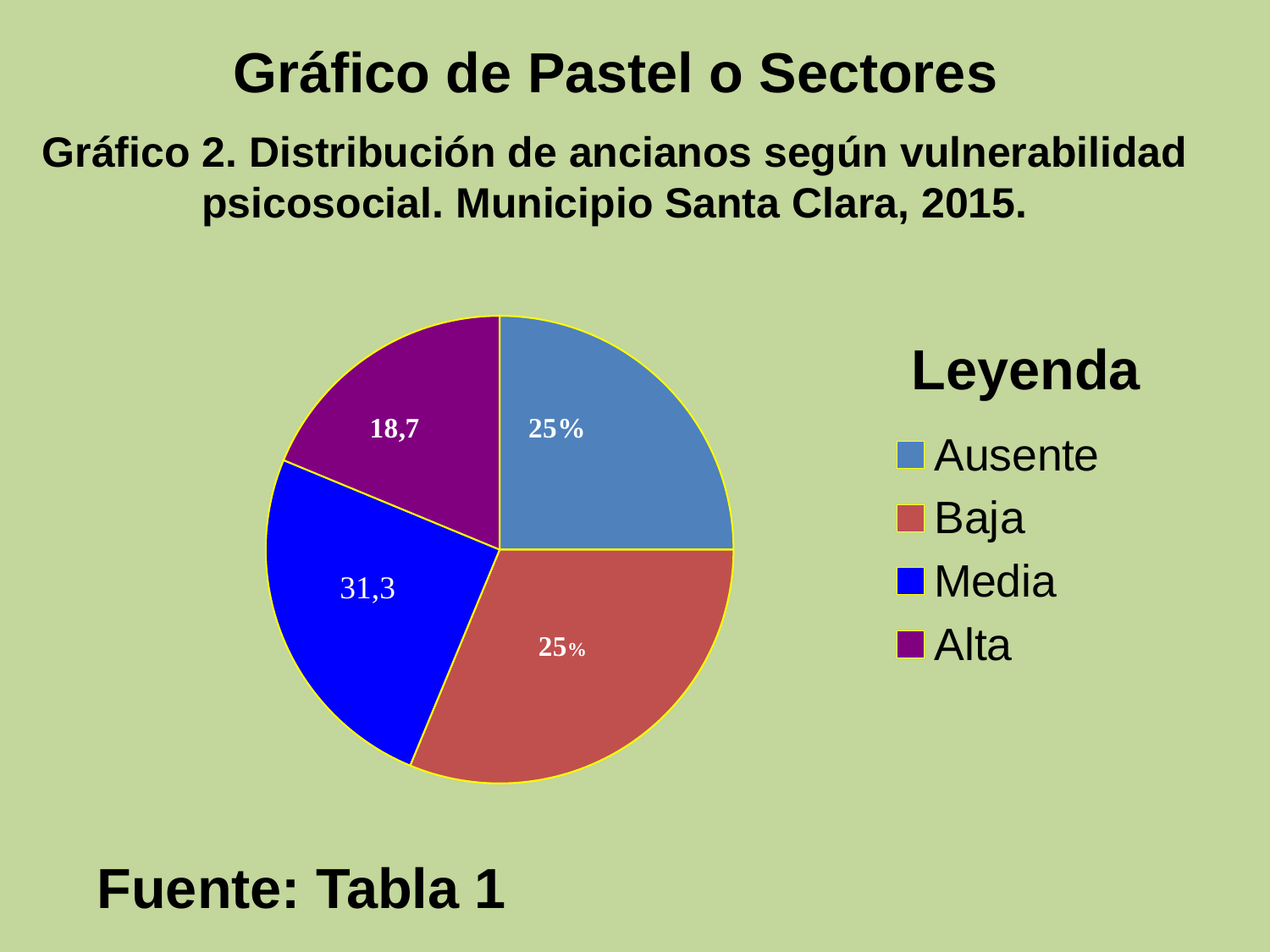
What value is shown for the Media slice? 31,3 What colour is the Media slice in the pie chart? Blue What value is shown for the Alta slice? 18,7 Which is larger, the Media slice or the Alta slice? Media What kind of chart is shown on the slide? Pie chart Which category has the smallest slice of the pie? Alta What value is shown for the Ausente slice? 25% How many slices does the pie chart have? 4 How many entries does the legend list? 4